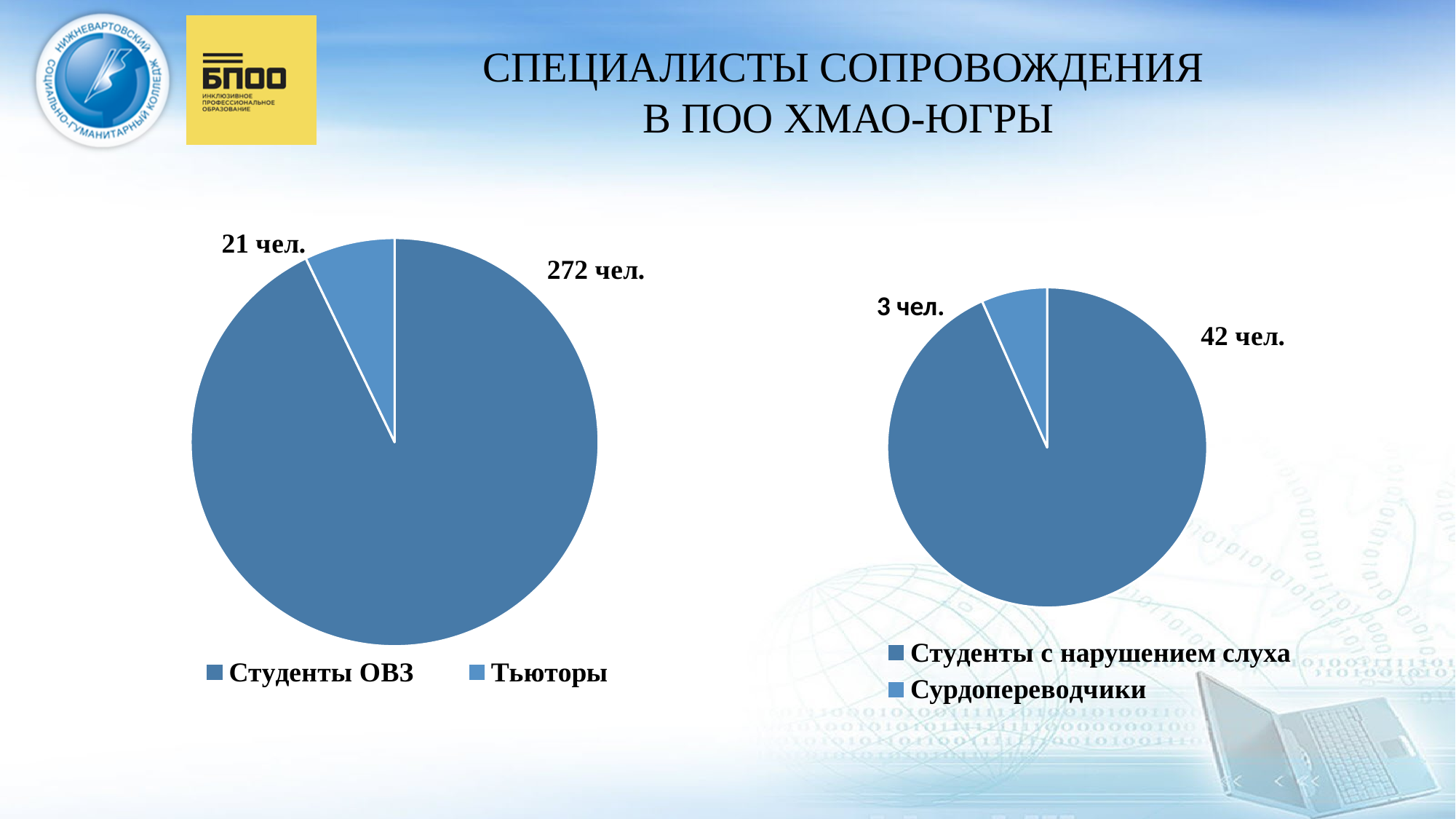
In the right pie chart, what is the value for Студенты с нарушением слуха? 42 чел. What kind of chart is the right chart? Pie chart In the left pie chart, what is the value for Студенты ОВЗ? 272 чел. In the left pie chart, what is the difference between Студенты ОВЗ and Тьюторы? 251 чел. In the right pie chart, what is the total of the two slices? 45 чел. How many slices does the left pie chart have? 2 In the right pie chart, which category is the smallest? Сурдопереводчики In the right pie chart, what is the difference between Студенты с нарушением слуха and Сурдопереводчики? 39 чел. In the left pie chart, what is the value for Тьюторы? 21 чел. In the left pie chart, which category is the largest? Студенты ОВЗ In the left pie chart, which is larger: Тьюторы or Студенты ОВЗ? Студенты ОВЗ In the right pie chart, what is the value for Сурдопереводчики? 3 чел.